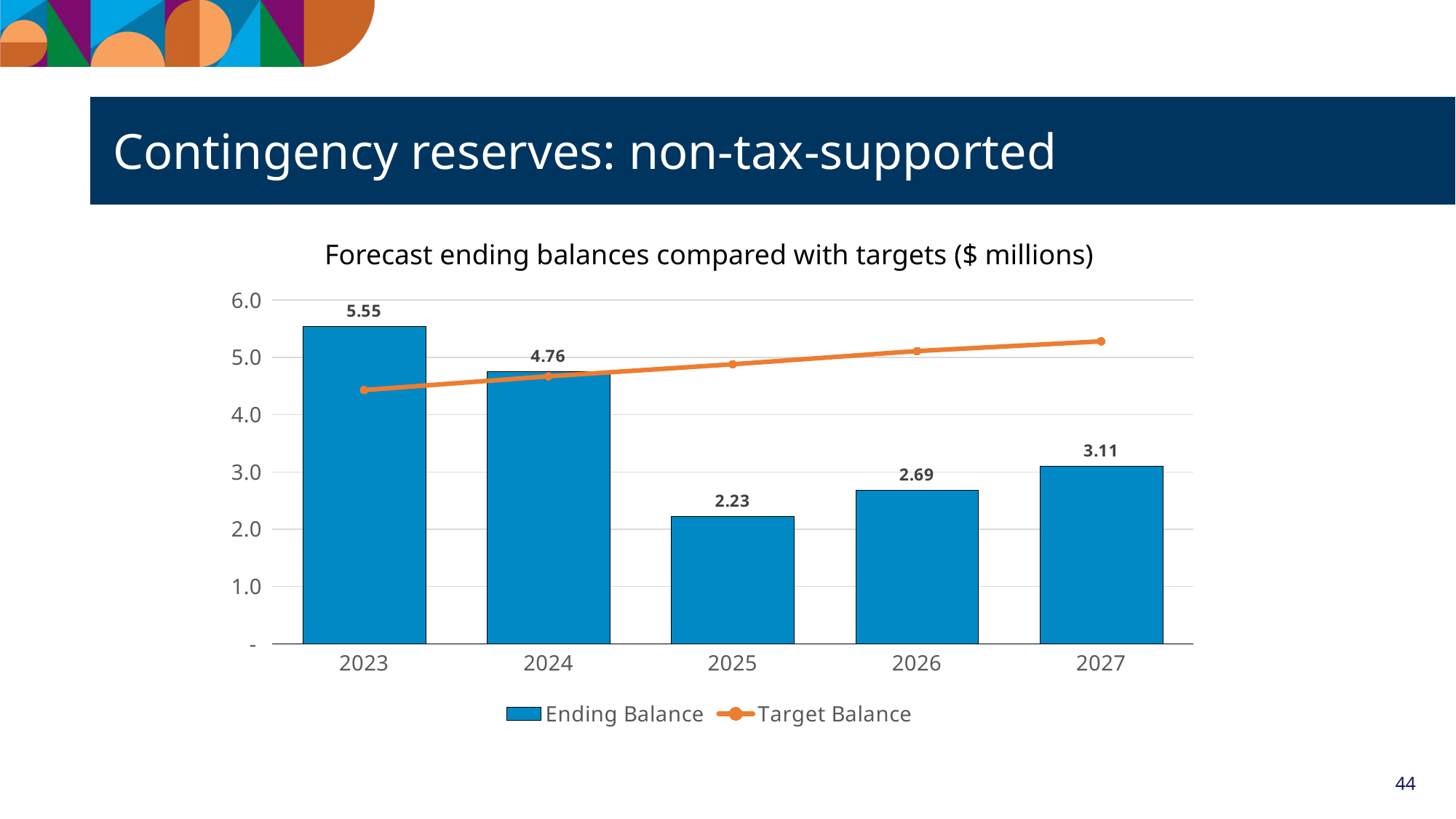
How many years are shown on the x axis? 5 Which year has the lowest Ending Balance? 2025 Which is larger, the Ending Balance in 2026 or in 2027? 2027 What is the difference between the Ending Balance in 2023 and in 2024? 0.79 How many series does the legend list? 2 What is the title of the chart? Forecast ending balances compared with targets ($ millions) What is the Ending Balance for 2027? 3.11 What is the Ending Balance for 2023? 5.55 What is the Ending Balance for 2025? 2.23 Is the Target Balance for 2027 greater or less than 5.0? greater Is the Target Balance for 2023 greater or less than 5.0? less Which year has the highest Ending Balance? 2023